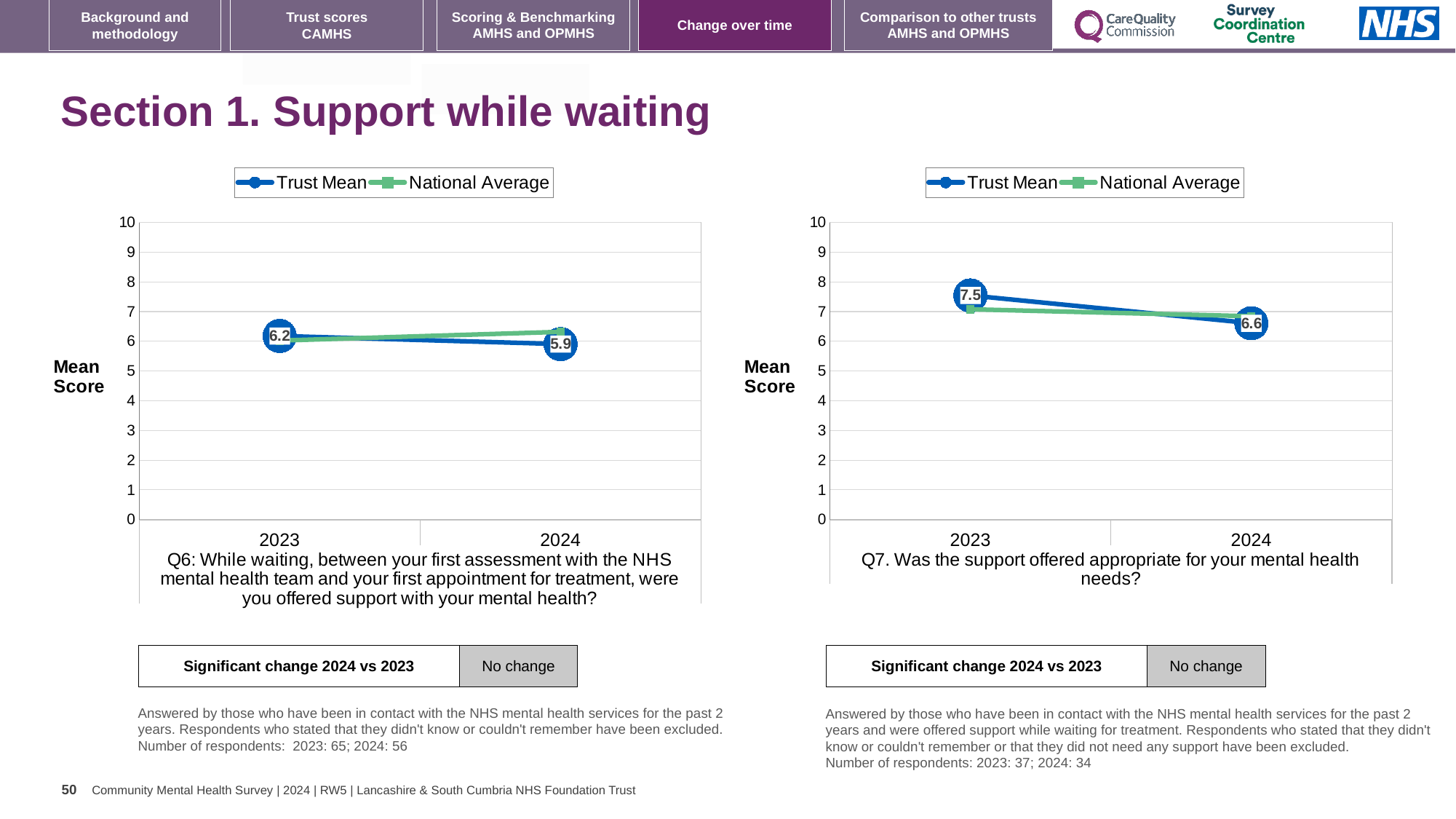
In the Q7 chart on the right, does the Trust Mean rise or fall from 2023 to 2024? fall How many series does the legend of the Q7 chart on the right list? 2 In the Q6 chart on the left, what is the Trust Mean for 2024? 5.9 In the Q7 chart on the right, by how much did the Trust Mean fall from 2023 to 2024? 0.9 In the Q6 chart on the left, what is the difference between the Trust Mean in 2023 and in 2024? 0.3 How many years are shown on the x axis of the Q6 chart on the left? 2 In the Q7 chart on the right, is the National Average for 2023 greater or less than 8? less In the Q6 chart on the left, what is the Trust Mean for 2023? 6.2 In the Q7 chart on the right, what is the Trust Mean for 2023? 7.5 In the Q7 chart on the right, what is the Trust Mean for 2024? 6.6 What kind of chart is the Q6 chart on the left? line chart In the Q7 chart on the right, which year has the higher Trust Mean, 2023 or 2024? 2023